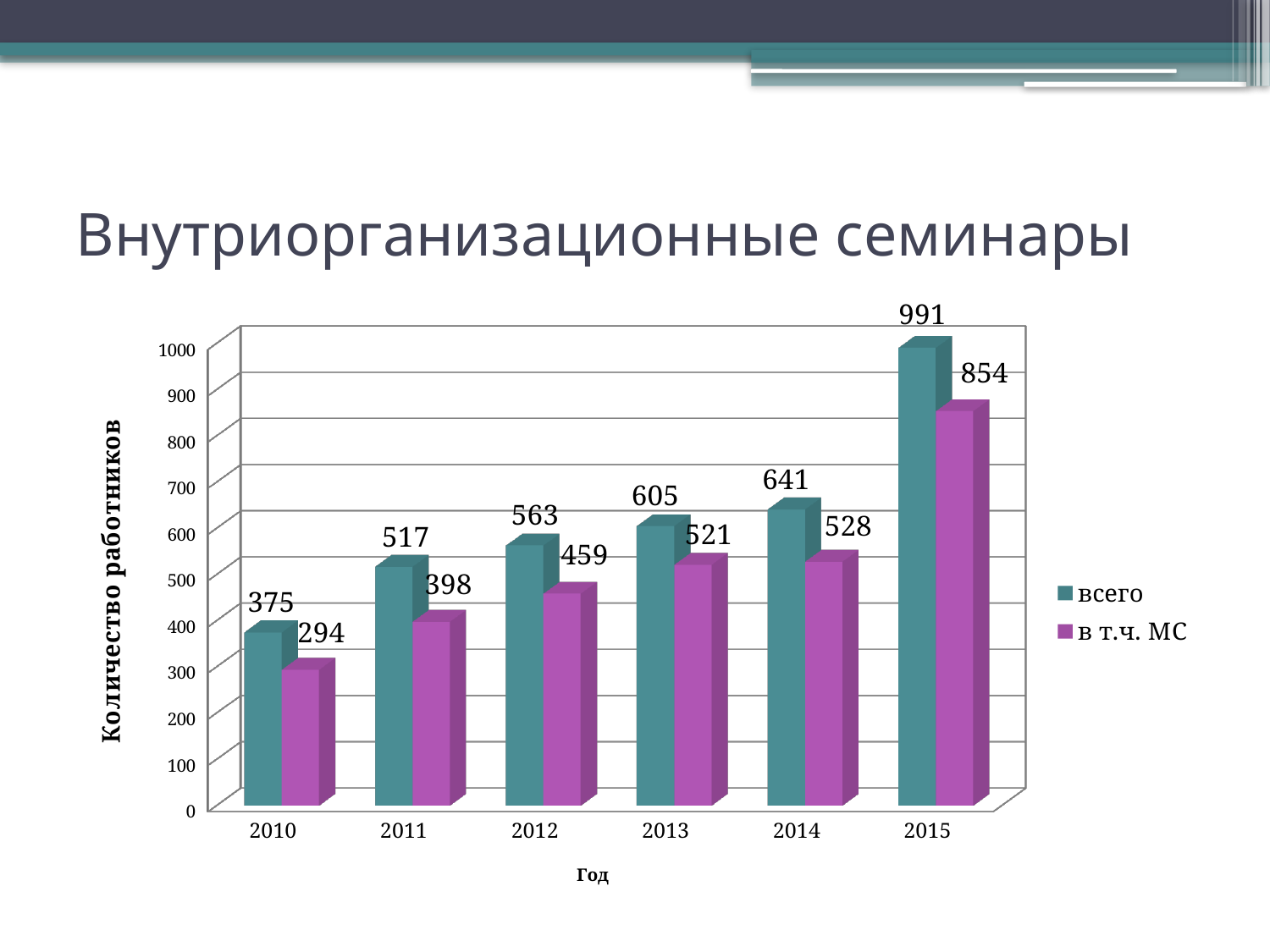
What is the value of "в т.ч. МС" for 2014? 528 Which is larger: "в т.ч. МС" in 2013 or "в т.ч. МС" in 2012? 2013 What is the difference between the "всего" values for 2011 and 2010? 142 Do the "всего" values rise or fall from 2010 to 2015? rise What is the value of "всего" for 2012? 563 What is the difference between "всего" and "в т.ч. МС" in 2015? 137 What kind of chart is shown on the slide? bar chart How many series does the legend list? 2 Which year has the lowest value for "в т.ч. МС"? 2010 How many years are shown on the x axis? 6 Which year has the highest value for "всего"? 2015 Is the value of "всего" for 2014 greater or less than 600? greater